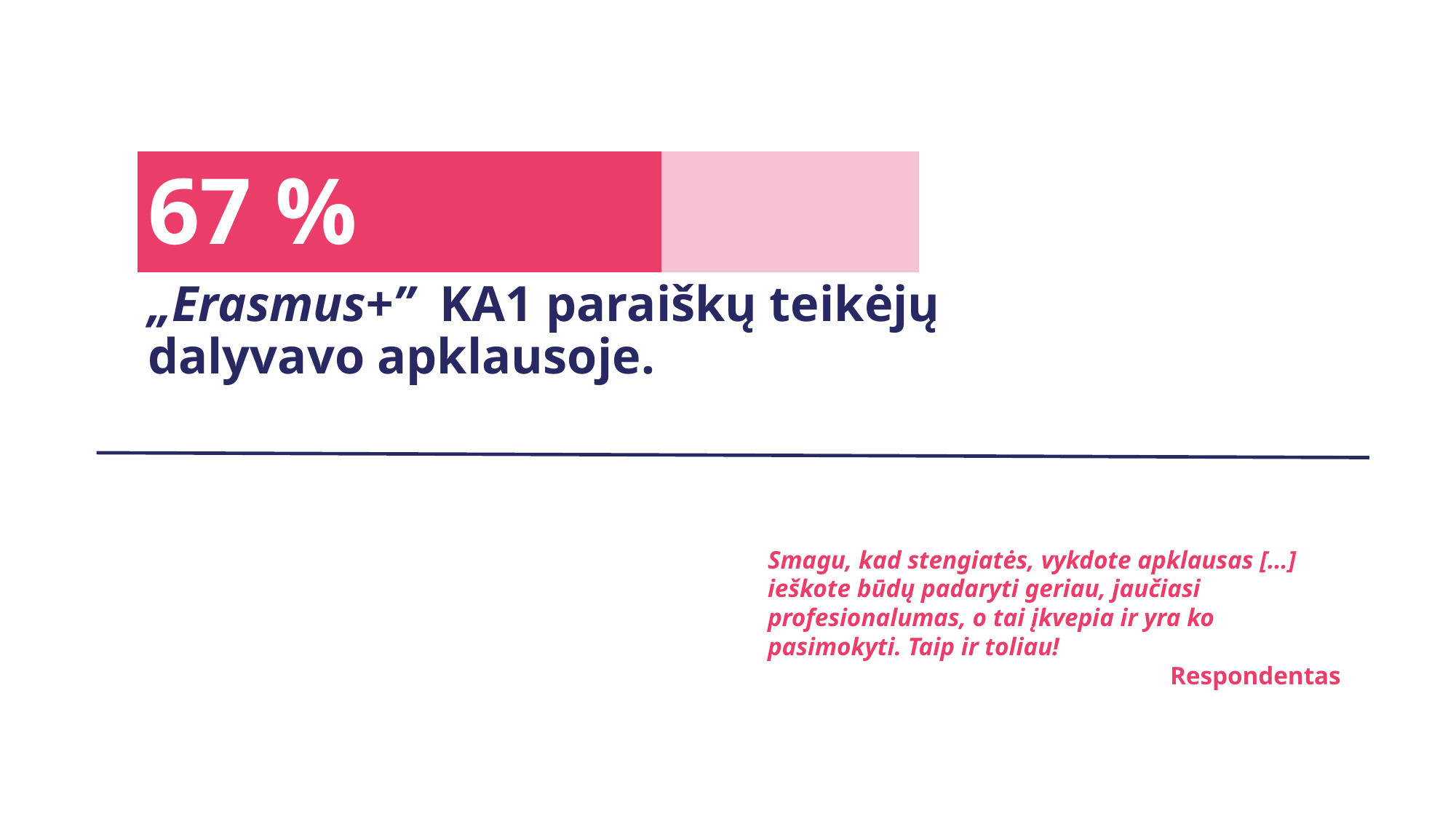
How many segments does the bar have? 2 What percentage of "Erasmus+" KA1 applicants participated in the survey, according to the bar? 67 % Is the bar oriented horizontally or vertically? horizontally Is the filled portion of the bar greater or less than half of the full bar? greater What colour is the filled (67 %) portion of the bar? dark pink What kind of chart is used to show the share of "Erasmus+" KA1 applicants who participated in the survey? bar chart What value is printed inside the filled portion of the bar? 67 %